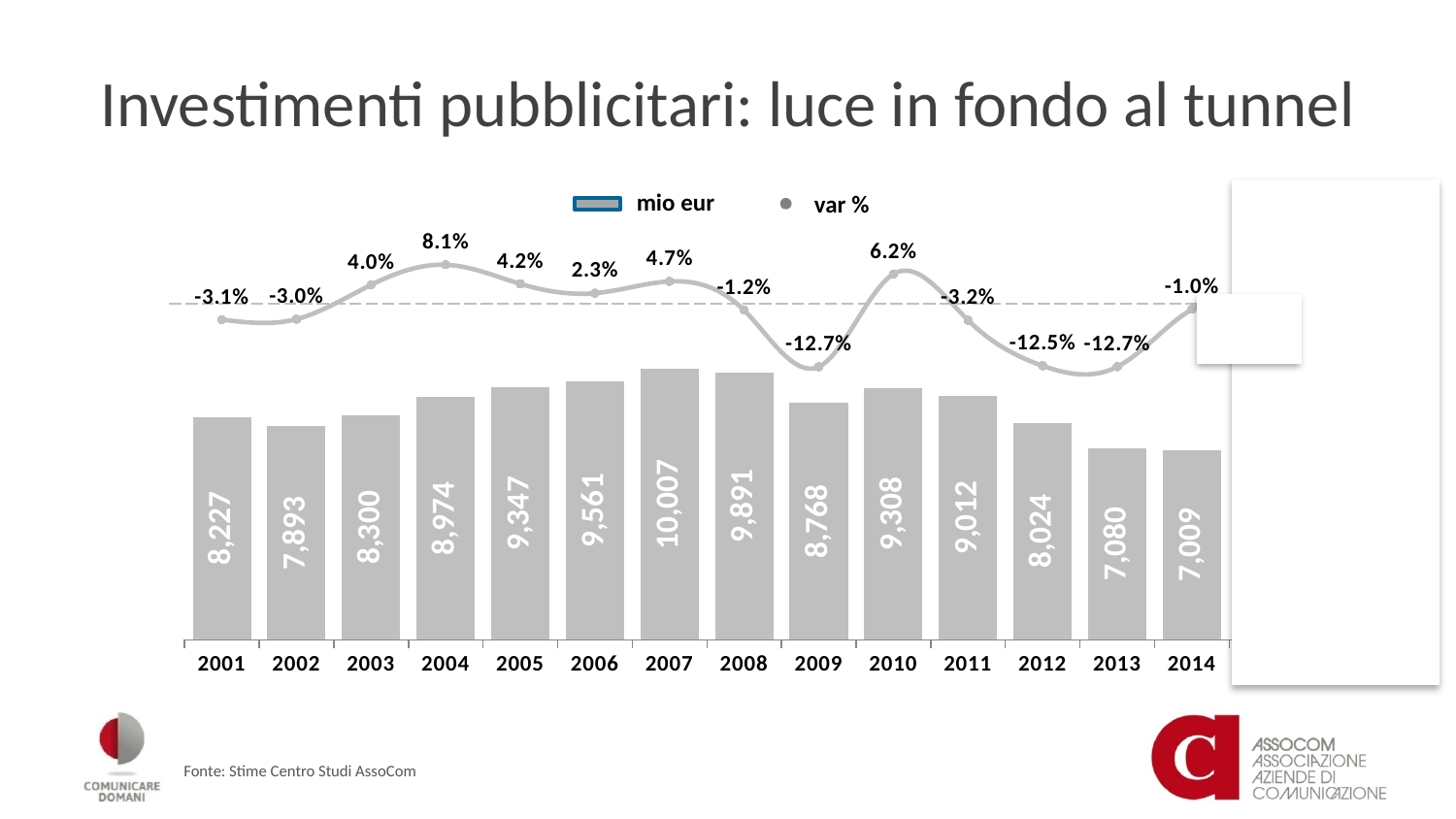
What is the var % value for 2009? -12.7% What is the mio eur value for 2007? 10,007 What are the two series named in the legend? mio eur and var % What is the var % value for 2004? 8.1% What is the difference in mio eur between 2007 and 2014? 2,998 Which year has the highest var % value? 2004 Which year has the highest mio eur value? 2007 How many years are shown on the x axis? 14 How many series does the legend list? 2 What is the mio eur value for 2014? 7,009 Which year has the lowest mio eur value? 2014 Which year has a larger mio eur value, 2010 or 2011? 2010